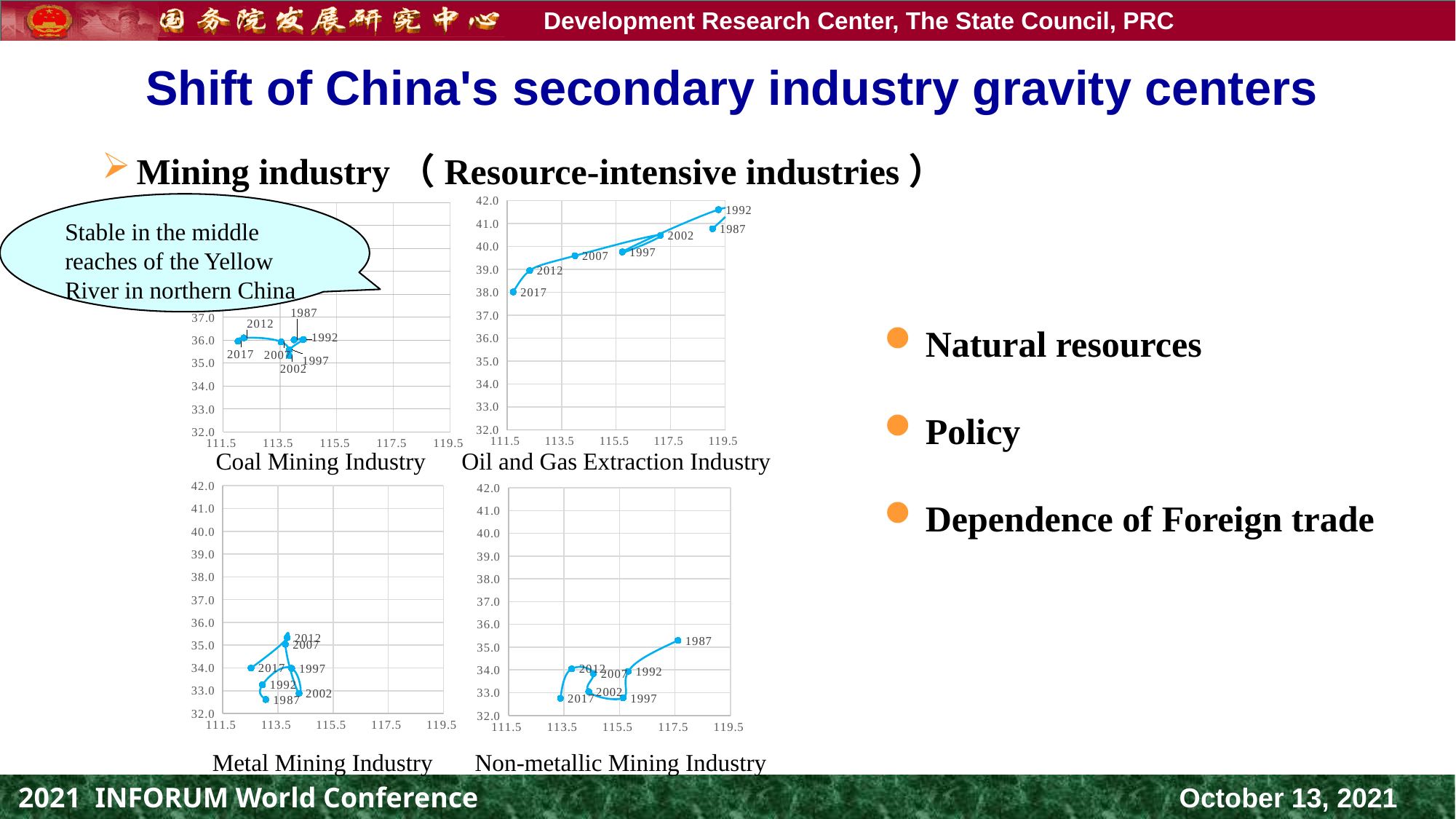
How many charts are shown on the slide? 4 What kind of chart is the Coal Mining Industry chart? Scatter chart with connected points In the Oil and Gas Extraction Industry chart, is the vertical value for 2017 greater or less than 39.0? less In the Metal Mining Industry chart, is the vertical value for 2012 greater or less than 35.0? greater In the Oil and Gas Extraction Industry chart, which year has the lowest vertical value? 2017 In the Oil and Gas Extraction Industry chart, is the vertical value for 1992 greater or less than 41.0? greater In the Oil and Gas Extraction Industry chart, how many year points are plotted? 7 In the Non-metallic Mining Industry chart, which year has the highest vertical value? 1987 In the Oil and Gas Extraction Industry chart, which year has the highest vertical value? 1992 In the Oil and Gas Extraction Industry chart, does the vertical value rise or fall from 1992 to 2017? fall In the Metal Mining Industry chart, which year has the highest vertical value? 2012